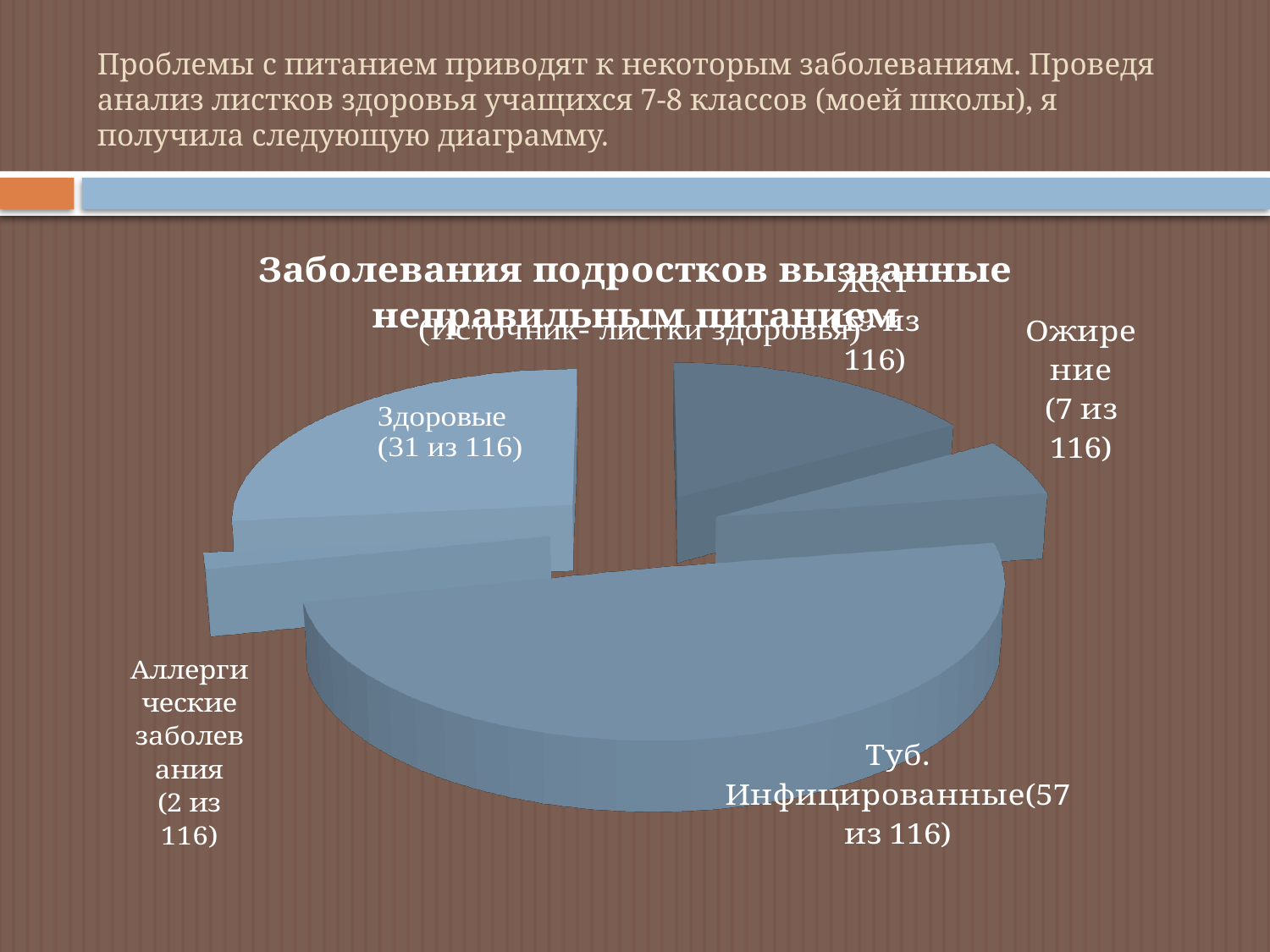
How many of the 116 students are labelled as Здоровые? 31 из 116 What source is named in the chart title? листки здоровья How many categories (slices) does the pie chart show? 5 How many of the 116 students are labelled as Туб. Инфицированные? 57 из 116 What is the difference between the number of Туб. Инфицированные students and the number of Здоровые students? 26 Which is larger: the number of students with Ожирение or the number with Аллергические заболевания? Ожирение What kind of chart is shown on the slide? pie chart What is the difference between the number of Здоровые students and the number with Ожирение? 24 Which category has the largest slice in the pie chart? Туб. Инфицированные How many of the 116 students are labelled as Аллергические заболевания? 2 из 116 How many of the 116 students are labelled as Ожирение? 7 из 116 Which category has the smallest slice in the pie chart? Аллергические заболевания